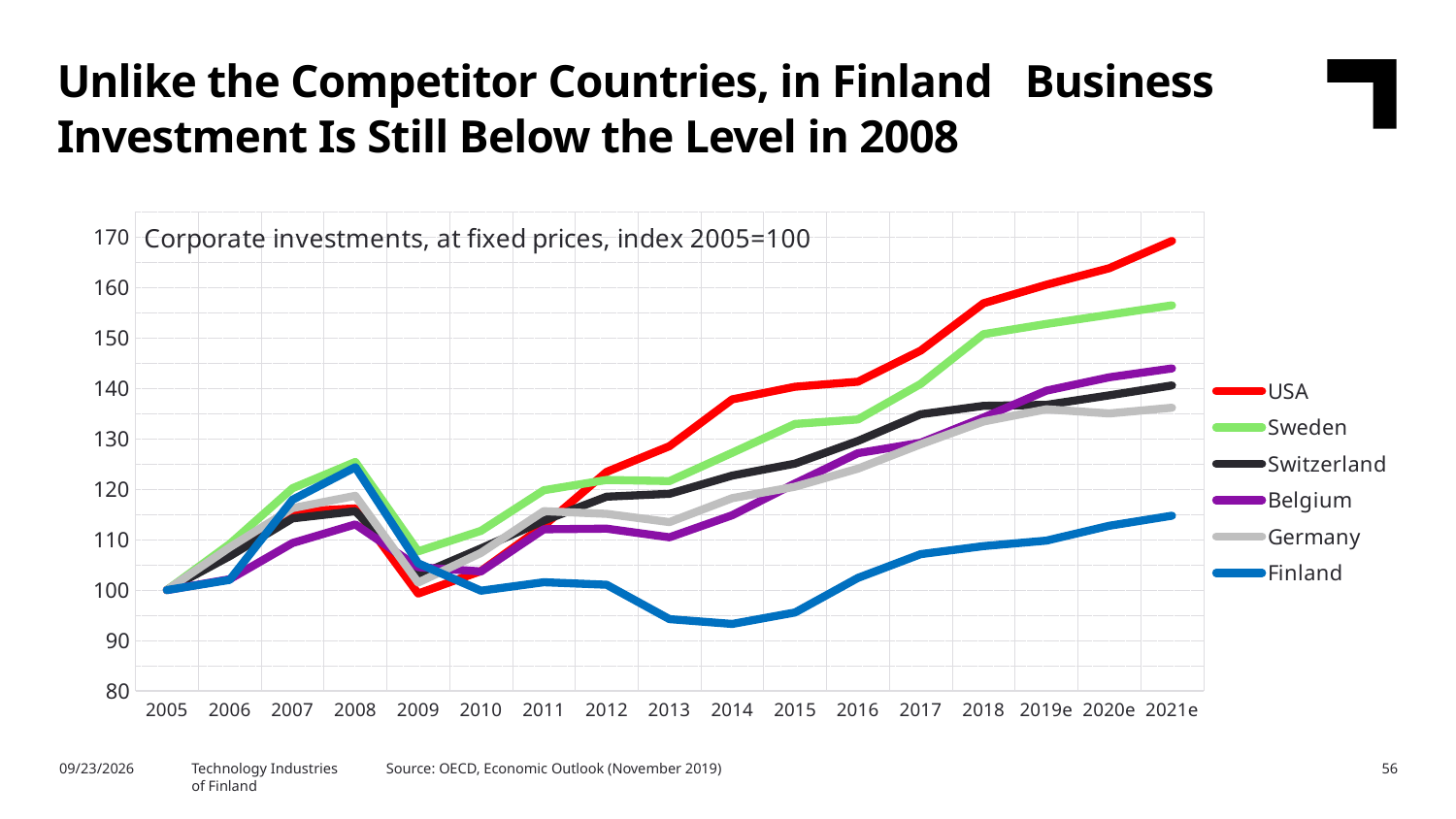
How many series does the legend list? 6 Which country has the lowest value in 2021e? Finland Is the value for USA in 2021e greater or less than 160? greater What is the index value for all countries in 2005? 100 Which is larger in 2021e, the value for Germany or the value for Finland? Germany What kind of chart is shown on the slide? line chart Which country has the lowest value in 2014? Finland What subtitle is printed inside the chart area? Corporate investments, at fixed prices, index 2005=100 How many years are shown along the x axis? 17 Is the value for Finland in 2014 greater or less than 100? less Which country has the highest value in 2021e? USA Is the value for Finland in 2021e greater or less than 120? less